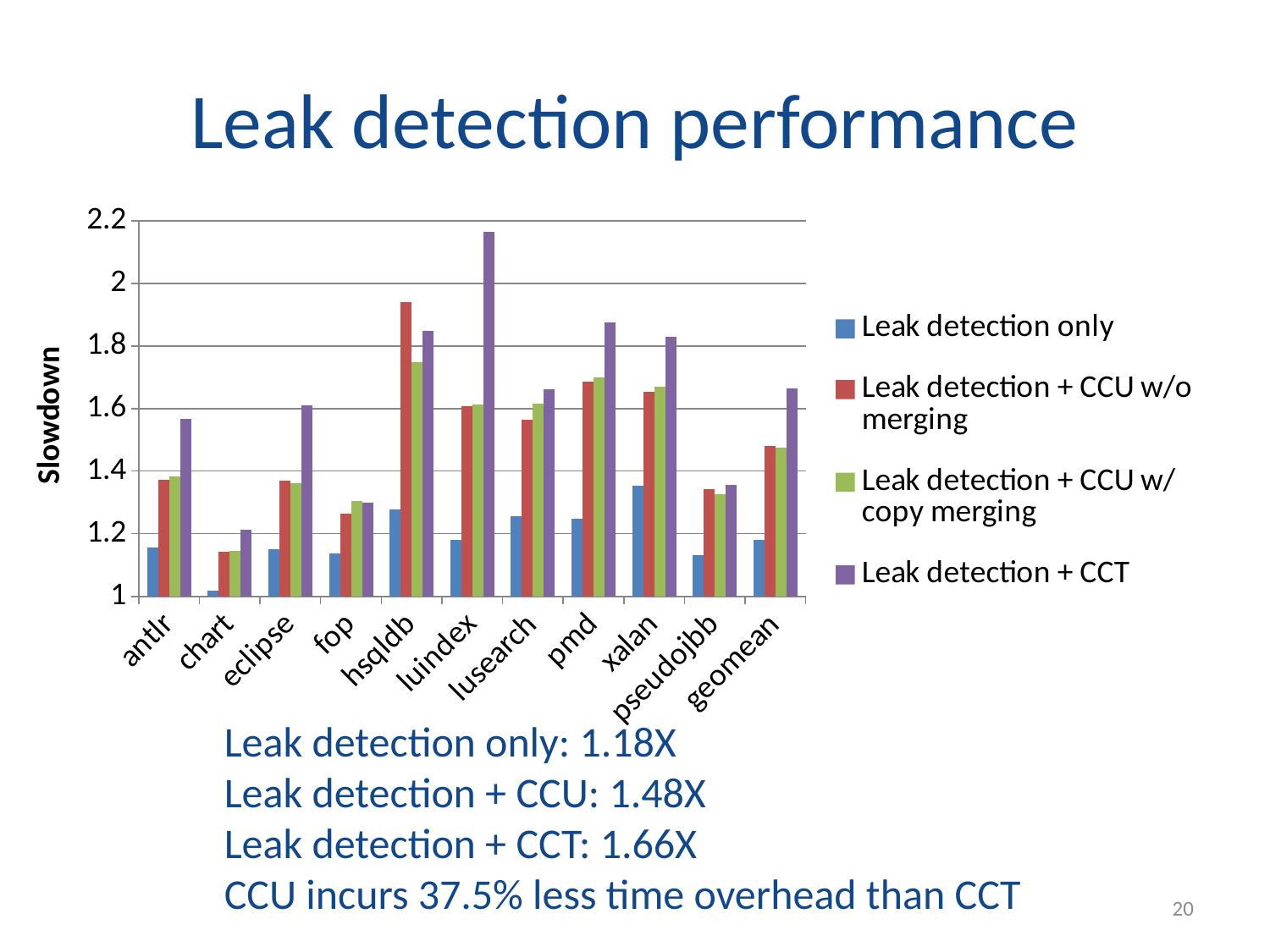
How many benchmark categories are shown along the x axis? 11 Is the Leak detection only value for chart greater or less than 1.2? less Which category has the lowest value for the Leak detection only series? chart What kind of chart is shown on the slide? bar chart For hsqldb, which is larger: Leak detection + CCU w/o merging or Leak detection + CCT? Leak detection + CCU w/o merging How many series does the legend list? 4 According to the slide text, what is the geomean slowdown for Leak detection only? 1.18X What is the label of the y axis? Slowdown Is the Leak detection + CCT value for pmd greater or less than 1.8? greater According to the slide text, what is the geomean slowdown for Leak detection + CCT? 1.66X Which category has the highest value for the Leak detection + CCT series? luindex Is the Leak detection + CCT value for luindex greater or less than 2? greater